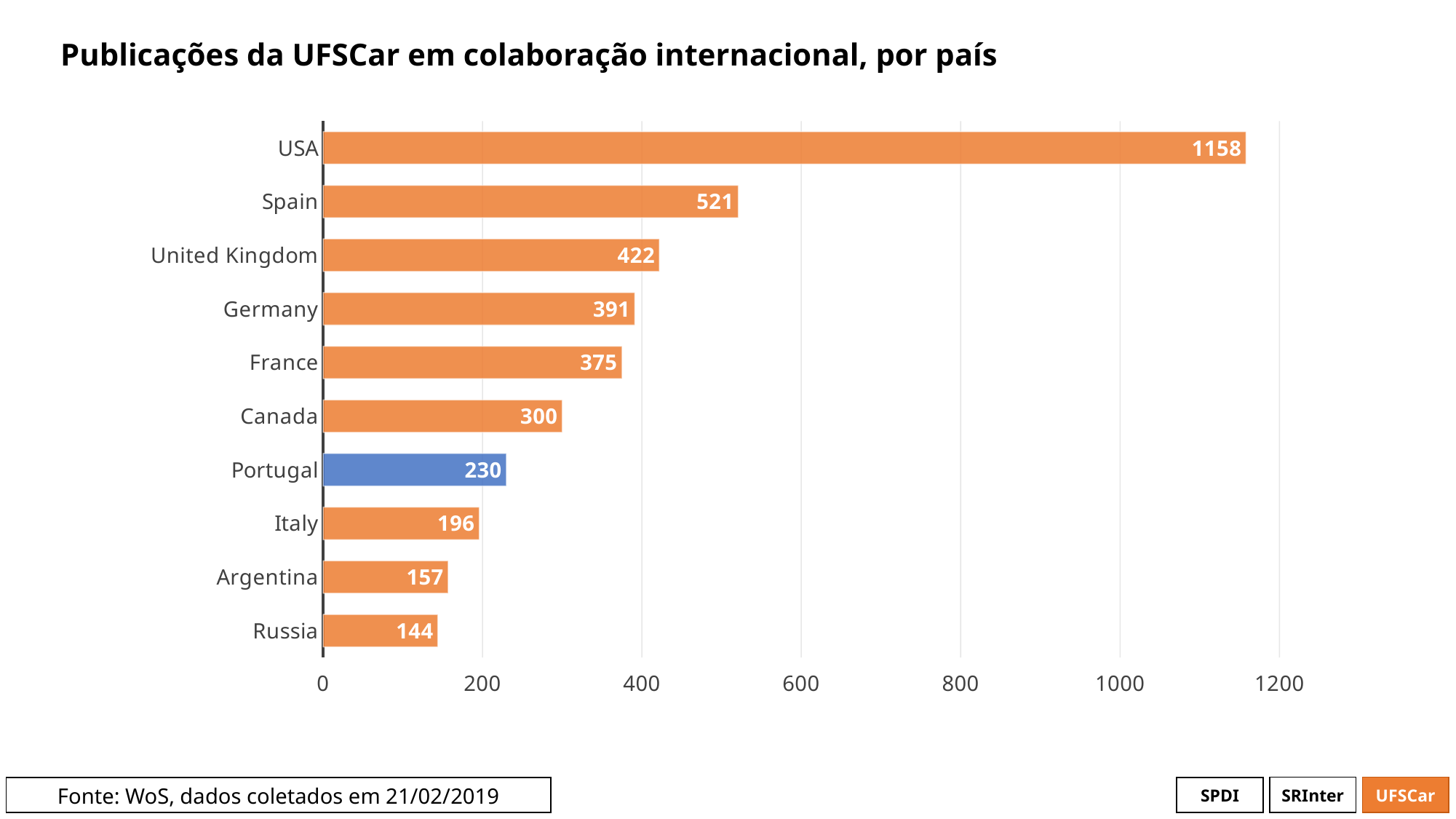
Which has a larger value, Canada or Italy? Canada Which country has the highest value? USA What kind of chart is this? bar chart Is the value for France greater or less than 400? less What is the value for Germany? 391 What is the difference between the values for Spain and United Kingdom? 99 How many countries are shown in the chart? 10 Which country's bar is coloured blue instead of orange? Portugal What is the value for USA? 1158 Which country has the lowest value? Russia What is the value for Portugal? 230 What is the title of the chart? Publicações da UFSCar em colaboração internacional, por país